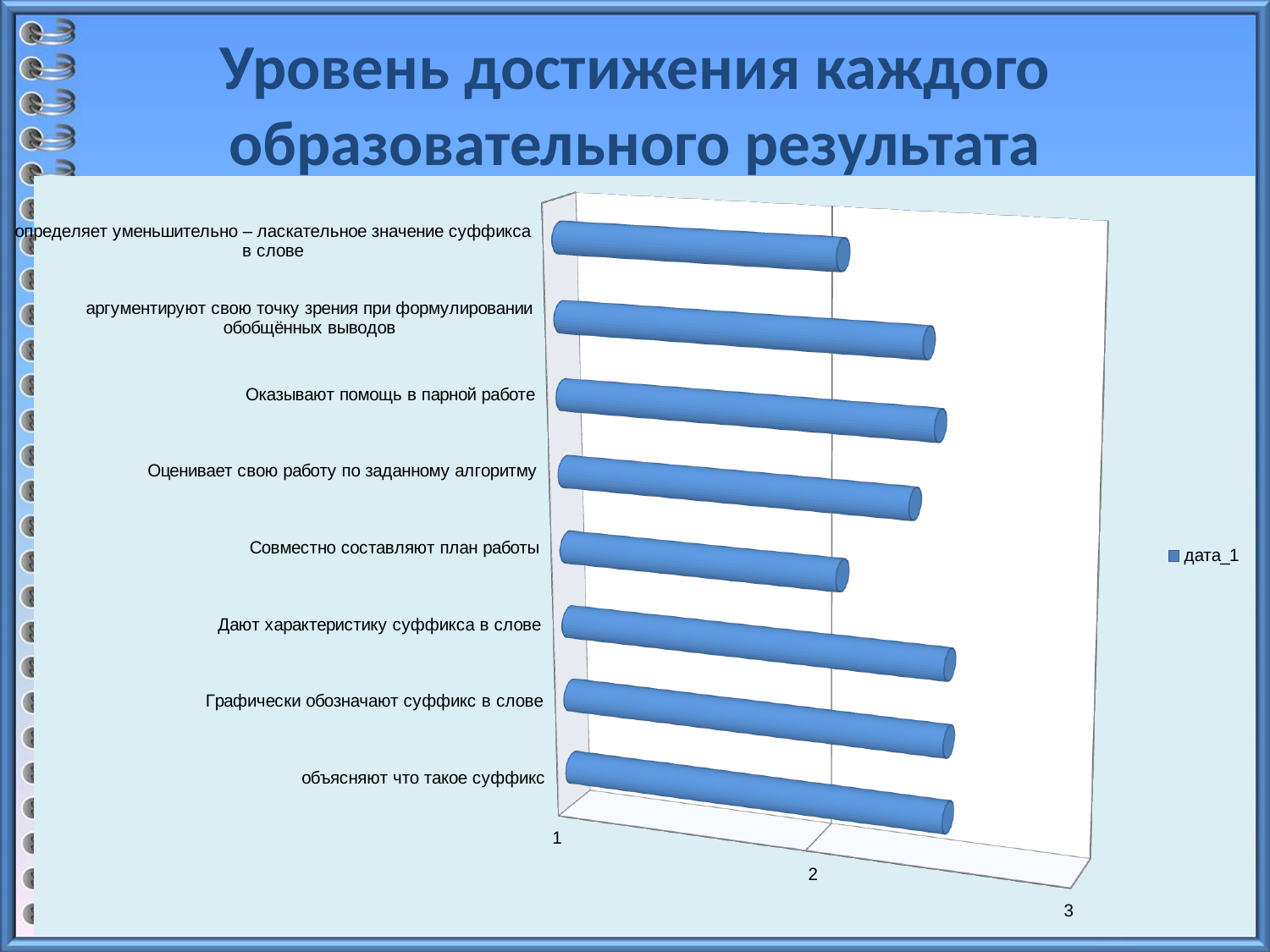
What is the title of the slide containing the chart? Уровень достижения каждого образовательного результата Is the value for "Оказывают помощь в парной работе" greater or less than 2? greater What kind of chart is shown on the slide? bar chart Is the value for "Дают характеристику суффикса в слове" greater or less than 3? less What is the name of the series shown in the legend? дата_1 Which is larger: the value for "Дают характеристику суффикса в слове" or for "определяет уменьшительно – ласкательное значение суффикса в слове"? Дают характеристику суффикса в слове Is the value for "объясняют что такое суффикс" greater or less than 2? greater How many series does the legend list? 1 How many categories are plotted on the chart? 8 Which is larger: the value for "Оказывают помощь в парной работе" or for "Совместно составляют план работы"? Оказывают помощь в парной работе